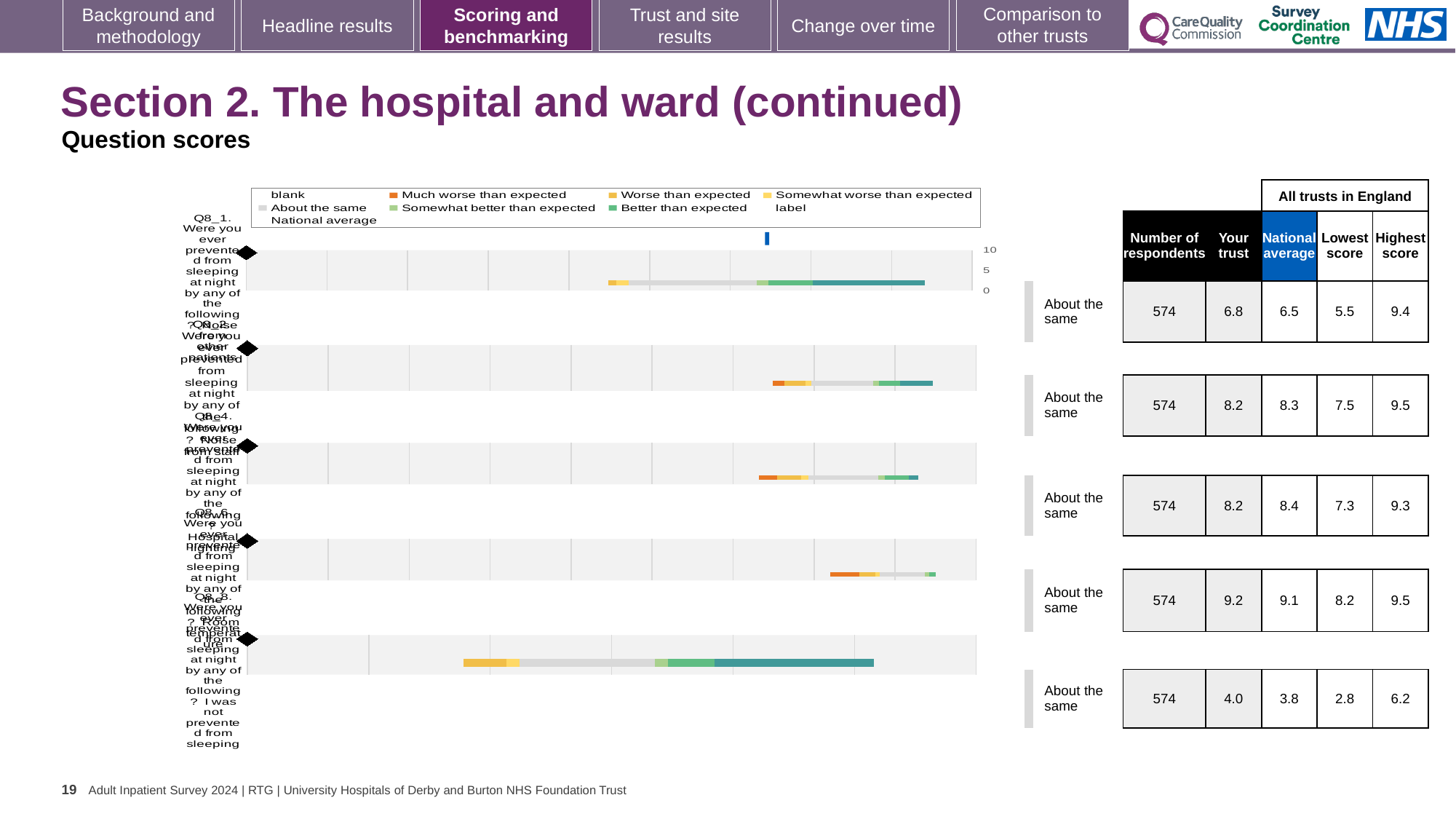
What is the question code of the first (top) bar in the chart? Q8_1 Which legend entry is shown in dark orange? Much worse than expected How many entries does the chart legend list? 9 What is the highest value shown on the chart's x axis? 10 What is the question code of the last (bottom) bar in the chart? Q8_8 What kind of chart is shown on the slide? bar chart How many question bars are plotted in the chart? 5